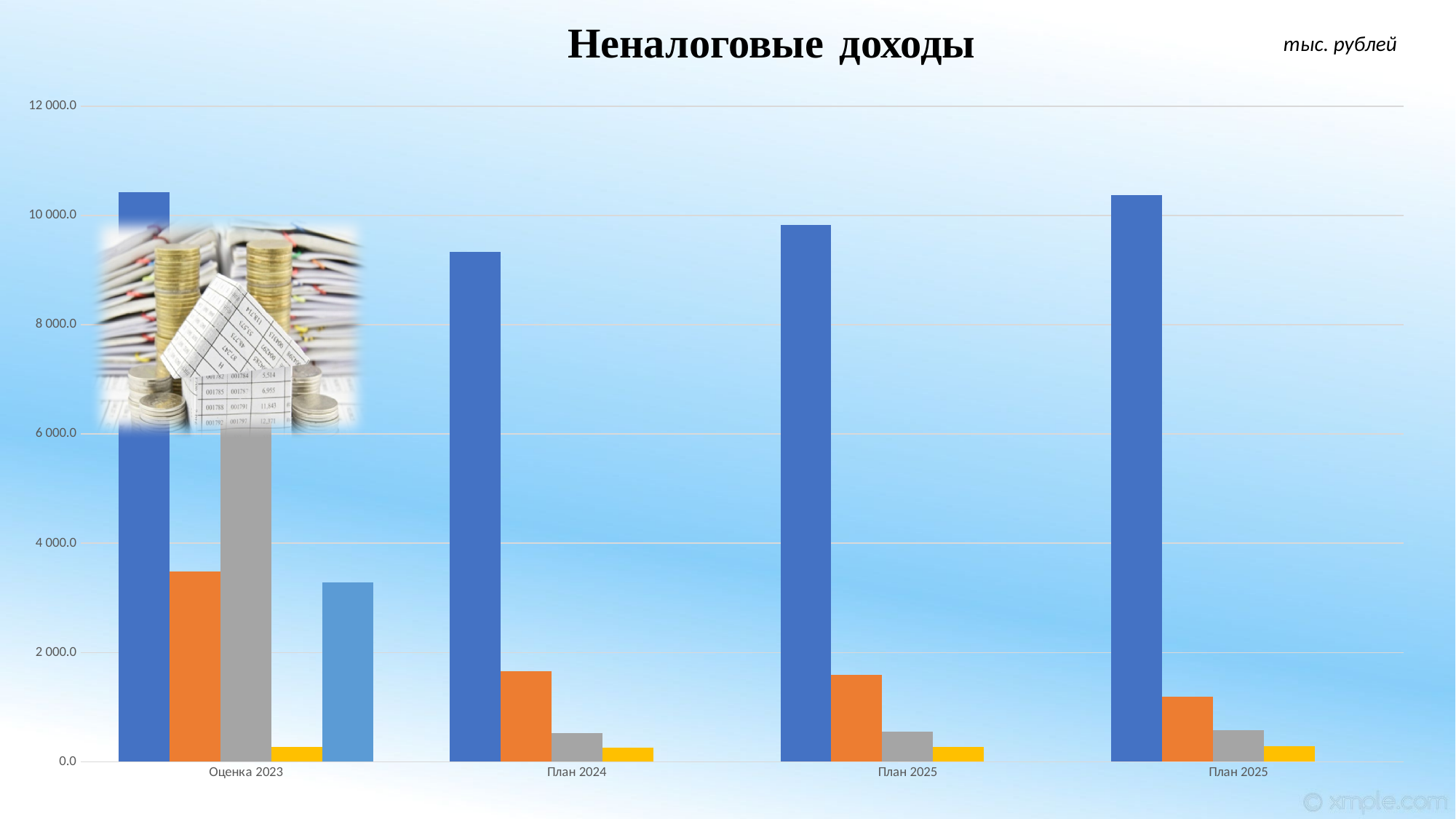
What is the title of the chart? Неналоговые доходы How many bars are in the План 2024 group? 4 Which is larger: the gray bar for Оценка 2023 or the gray bar for План 2024? Оценка 2023 Is the value of the dark blue bar for План 2024 greater or less than 10 000.0? less How many categories are shown along the x axis? 4 Is the value of the dark blue bar for Оценка 2023 greater or less than 10 000.0? greater What kind of chart is shown on the slide? bar chart How many bars are in the Оценка 2023 group? 5 What unit is indicated for the chart values? тыс. рублей Which category has the tallest orange bar? Оценка 2023 Is the value of the orange bar for План 2024 greater or less than 2 000.0? less